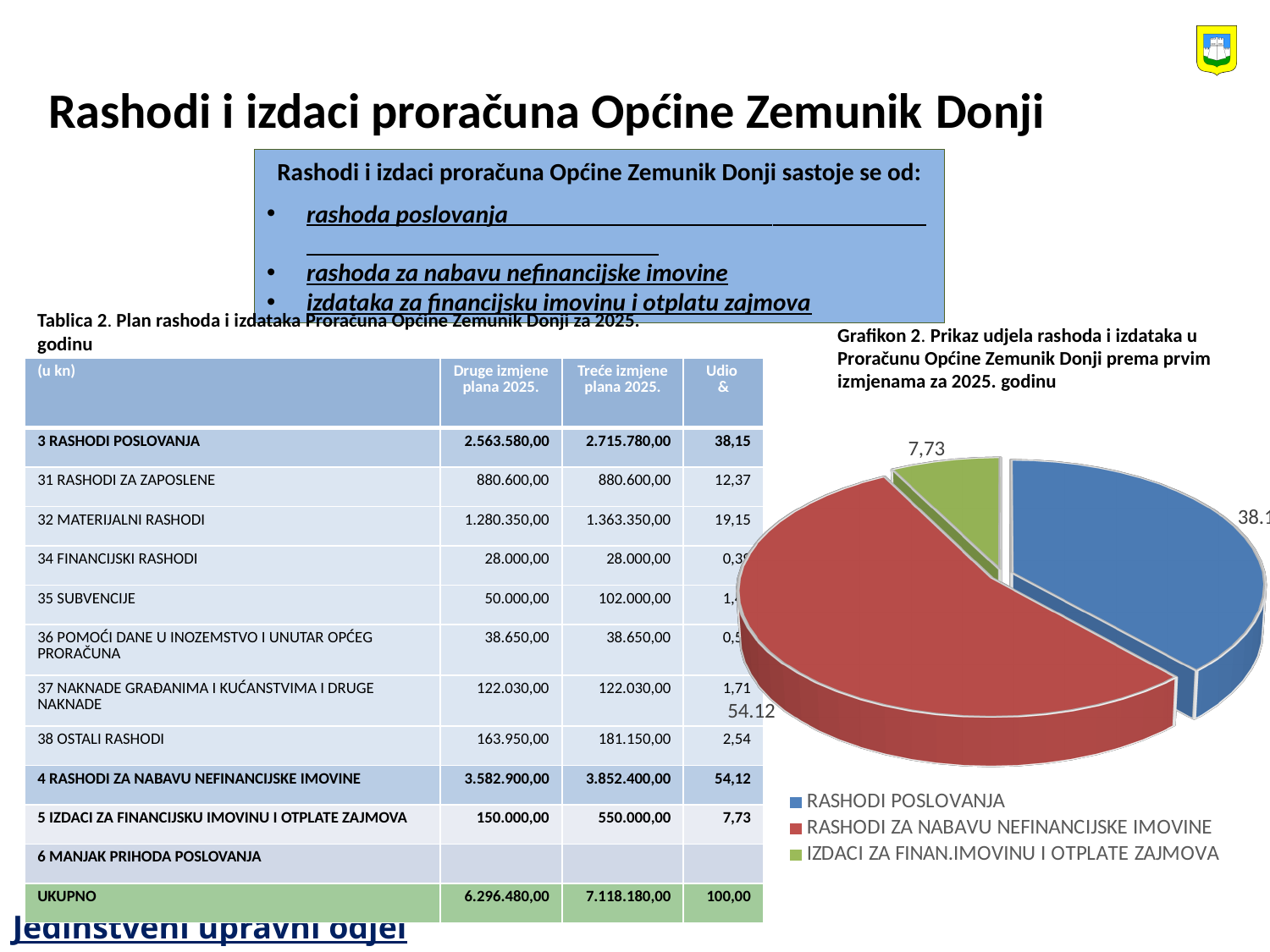
Which category has the largest slice in the pie chart? RASHODI ZA NABAVU NEFINANCIJSKE IMOVINE In the pie chart, what value is shown for RASHODI ZA NABAVU NEFINANCIJSKE IMOVINE? 54.12 What colour is the RASHODI ZA NABAVU NEFINANCIJSKE IMOVINE slice in the pie chart? red How many slices does the pie chart in Grafikon 2 have? 3 In the pie chart, what value is shown for IZDACI ZA FINAN.IMOVINU I OTPLATE ZAJMOVA? 7,73 What kind of chart is Grafikon 2 on the slide? pie chart In the pie chart, which slice is larger: RASHODI ZA NABAVU NEFINANCIJSKE IMOVINE or RASHODI POSLOVANJA? RASHODI ZA NABAVU NEFINANCIJSKE IMOVINE Which category has the smallest slice in the pie chart? IZDACI ZA FINAN.IMOVINU I OTPLATE ZAJMOVA In the pie chart, which slice is larger: RASHODI POSLOVANJA or IZDACI ZA FINAN.IMOVINU I OTPLATE ZAJMOVA? RASHODI POSLOVANJA What colour is the RASHODI POSLOVANJA slice in the pie chart? blue How many entries does the legend of the pie chart list? 3